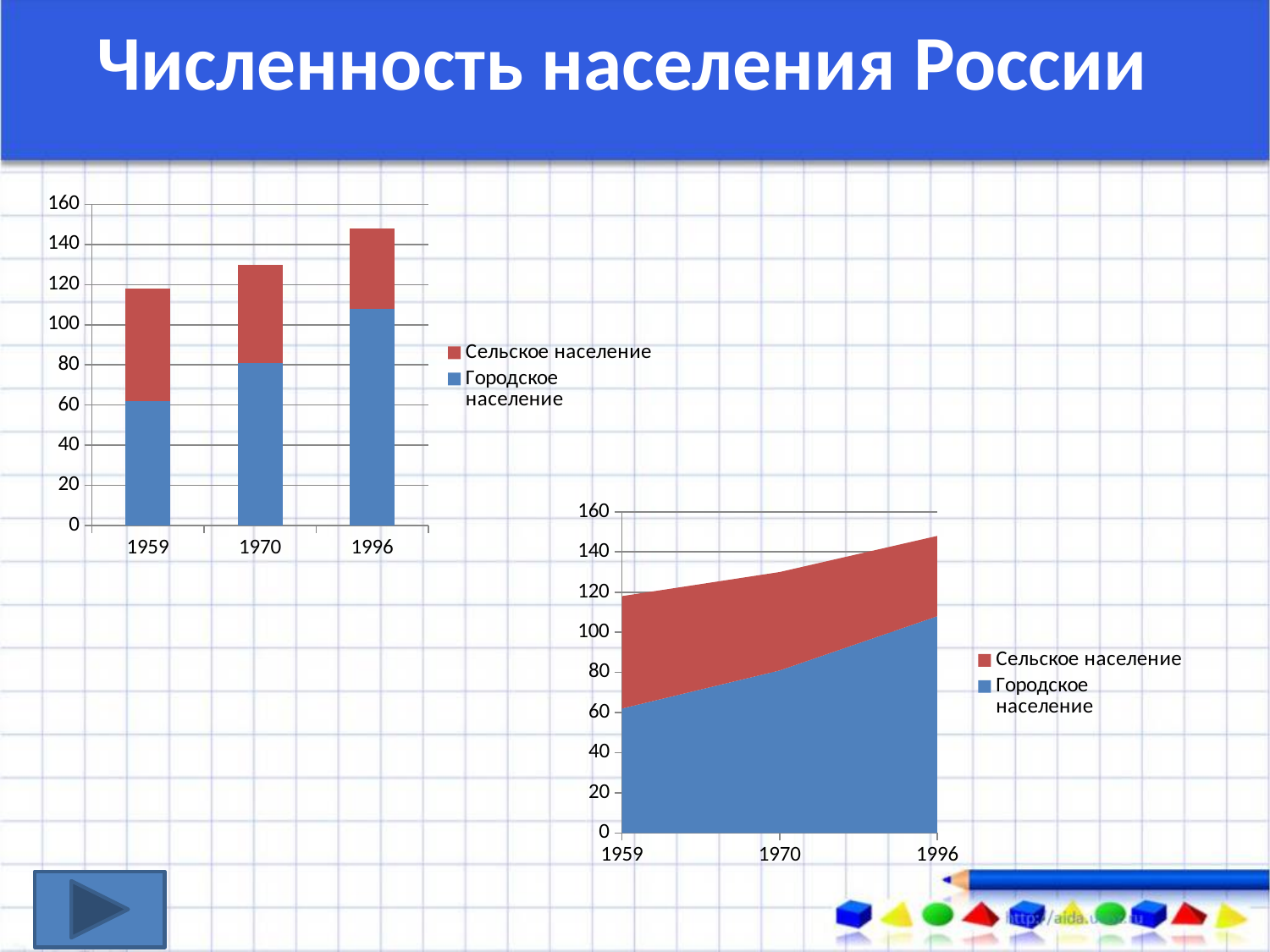
How many years are shown on the x axis of the left bar chart? 3 What kind of chart is the chart on the left of the slide? bar chart In the left bar chart, is the value for Городское население in 1959 greater or less than 80? less In the left bar chart, is the total height of the bar for 1996 greater or less than 140? greater In the right area chart, which series is larger in 1996, Городское население or Сельское население? Городское население In the left bar chart, which year has the tallest stacked bar? 1996 In the left bar chart, which year has the shortest stacked bar? 1959 In the left bar chart, is the value for Городское население in 1996 greater or less than 100? greater How many series does the legend of the left bar chart list? 2 What kind of chart is the chart on the right of the slide? area chart Which series is shown in red in both charts? Сельское население In the right area chart, does the total population rise or fall from 1959 to 1996? rise